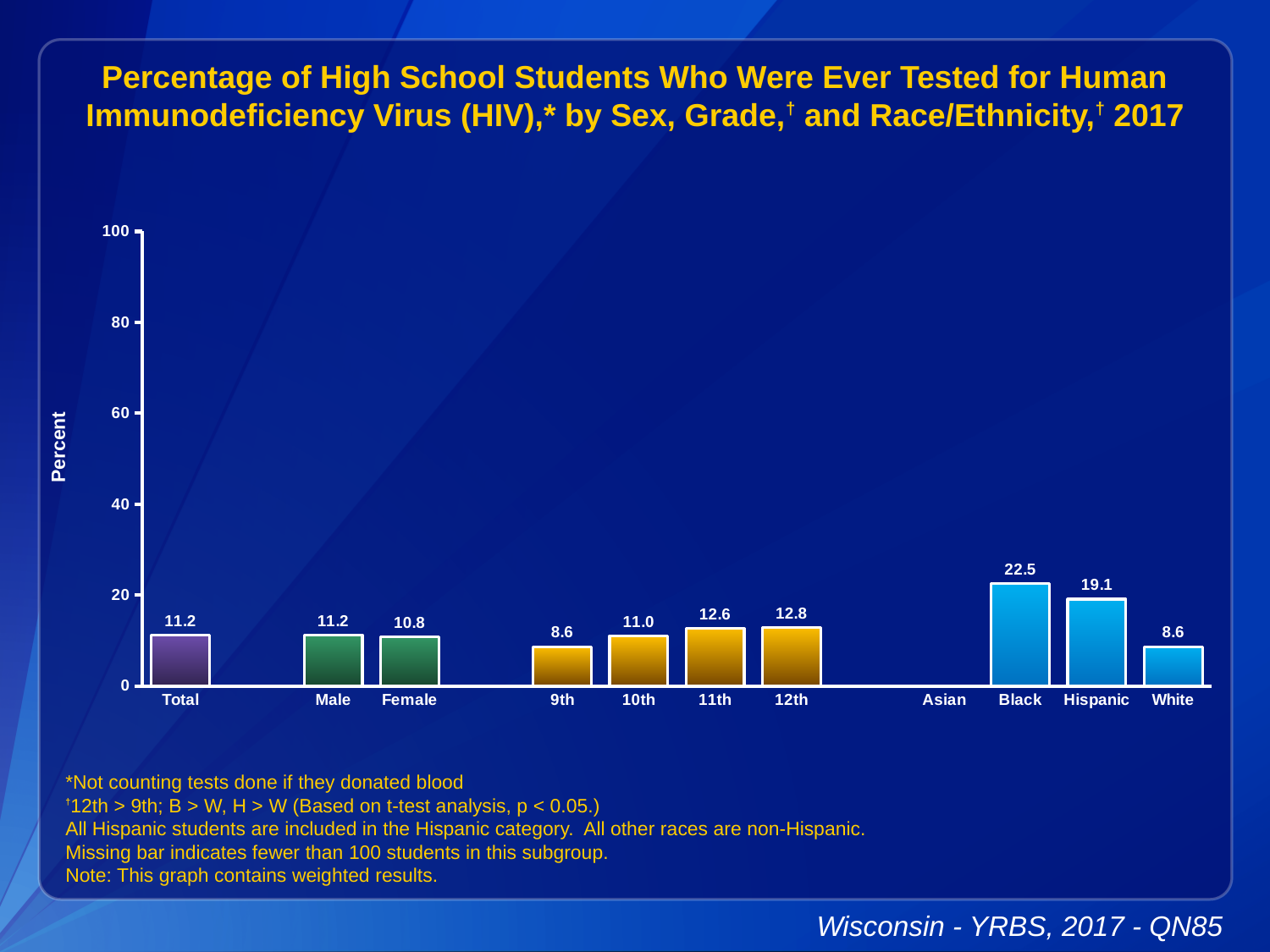
What is the difference between the values for Black and White students? 13.9 What is the value for Female? 10.8 Do the values rise or fall from 9th grade to 12th grade? rise What is the value for Total? 11.2 Which category has the highest value? Black Which category label has no bar shown? Asian What type of chart is shown? bar chart What is the value for 12th grade? 12.8 Which is larger, the value for 9th grade or 11th grade? 11th Is the value for Black students greater or less than 20? greater What is the value for Hispanic students? 19.1 What is the difference between the values for Male and Female? 0.4